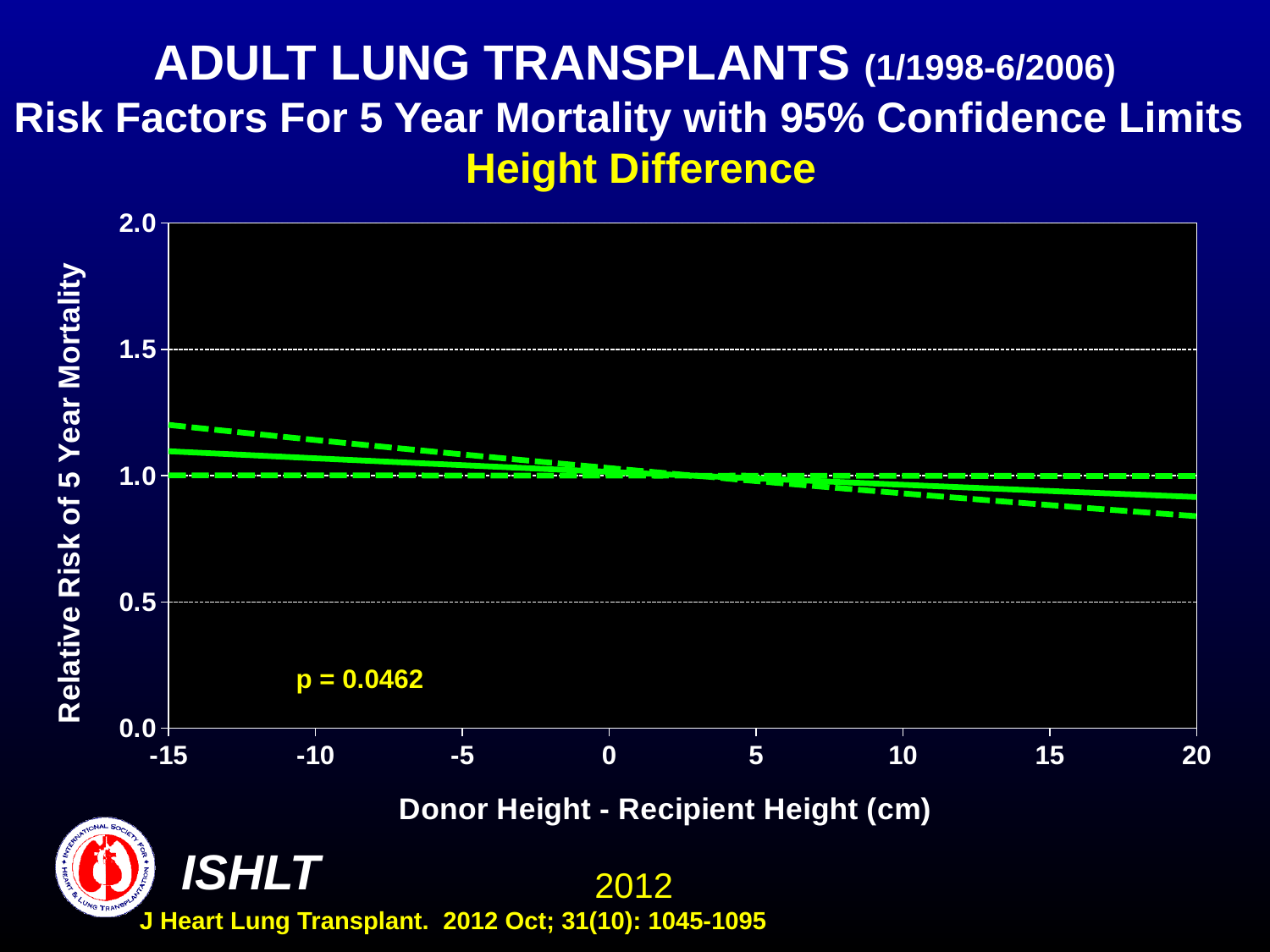
Is the solid relative risk line at a height difference of 20 cm greater or less than 1.0? less What p-value is printed on the chart? p = 0.0462 What kind of chart is shown on the slide? Line chart How many tick labels are shown on the x axis? 8 Is the lower dashed confidence limit at a height difference of 20 cm greater or less than 1.0? less Is the solid relative risk line at a height difference of -15 cm greater or less than 1.0? greater What is the maximum value shown on the y axis? 2.0 What is the label of the x axis? Donor Height - Recipient Height (cm) As Donor Height - Recipient Height increases from -15 to 20 cm, does the solid relative risk line rise or fall? Fall How many lines are plotted on the chart? 3